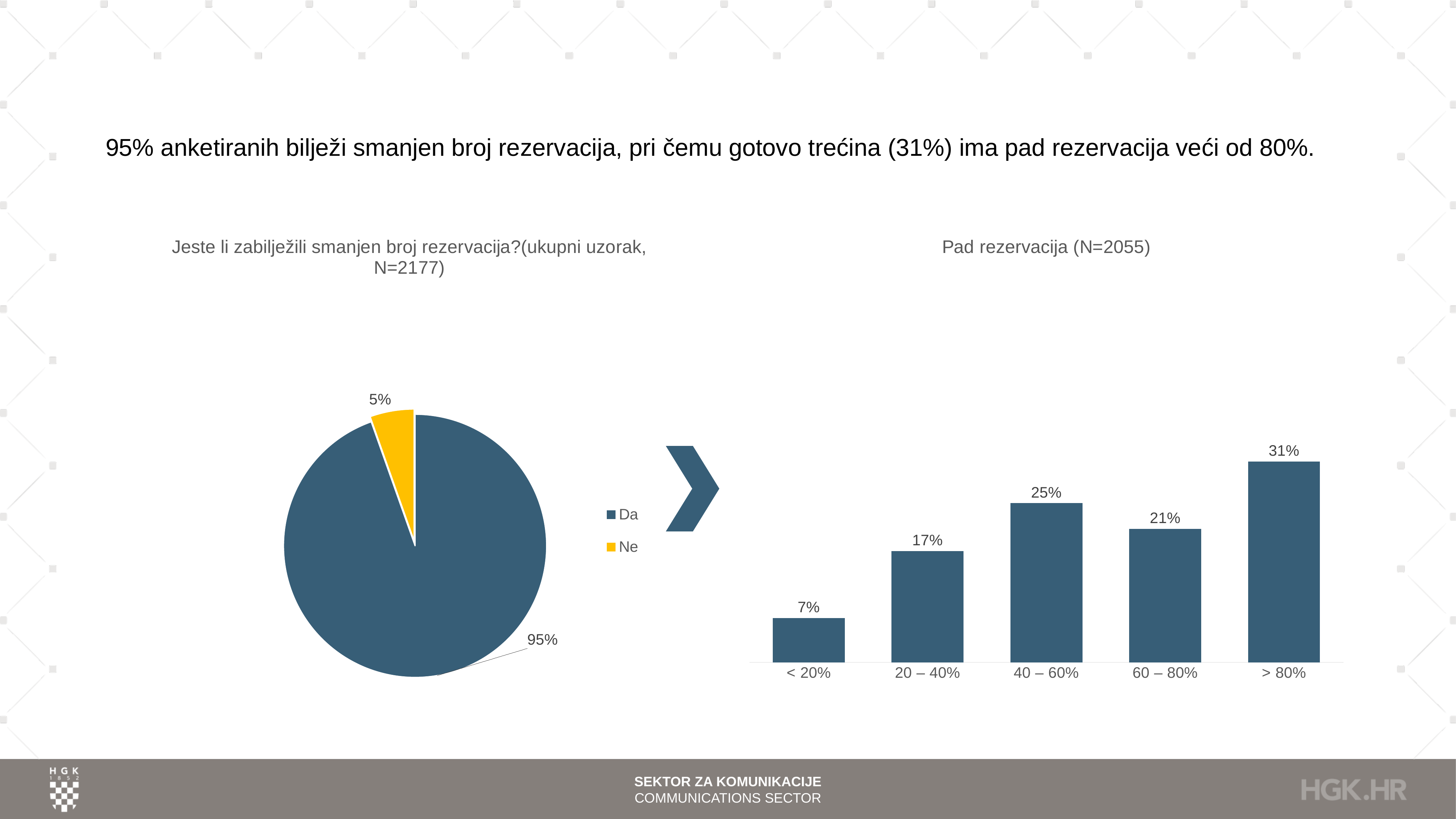
In the pie chart on the left, what share of respondents answered "Ne"? 5% In the pie chart on the left, what share of respondents answered "Da"? 95% What kind of chart is the chart on the left? pie chart In the pie chart on the left, which slice is coloured yellow? Ne In the "Pad rezervacija (N=2055)" chart, which category has the lowest value? < 20% In the pie chart on the left, how many entries does the legend list? 2 In the "Pad rezervacija (N=2055)" chart, which is larger: the value for "20 – 40%" or the value for "60 – 80%"? 60 – 80% How many categories are shown in the "Pad rezervacija (N=2055)" chart? 5 In the "Pad rezervacija (N=2055)" chart, what is the value for "> 80%"? 31% In the "Pad rezervacija (N=2055)" chart, which category has the highest value? > 80% In the "Pad rezervacija (N=2055)" chart, what is the value for "40 – 60%"? 25% In the "Pad rezervacija (N=2055)" chart, what is the difference between the values for "> 80%" and "< 20%"? 24%